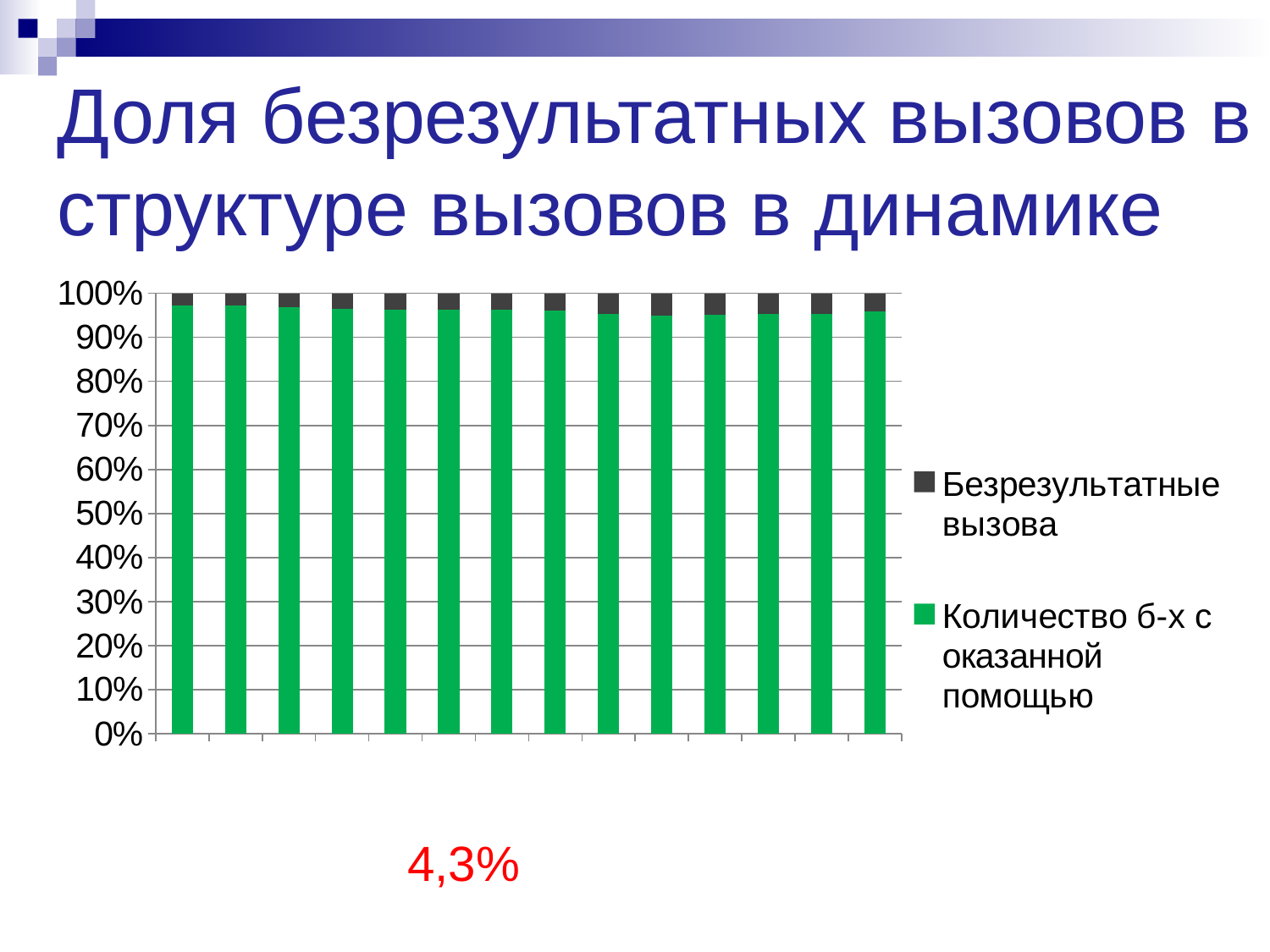
In the leftmost bar, which series has the larger share: Безрезультатные вызова or Количество б-х с оказанной помощью? Количество б-х с оказанной помощью Which series is shown in green in the legend? Количество б-х с оказанной помощью How many series does the legend list? 2 What is the highest tick value shown on the vertical axis? 100% Is the value of the green series (Количество б-х с оказанной помощью) for the leftmost bar greater or less than 90%? greater Is the value of the dark grey series (Безрезультатные вызова) for the leftmost bar greater or less than 10%? less What is the total height of each stacked bar on the percentage axis? 100% What kind of chart is shown on the slide? stacked bar chart What is the title of the chart on the slide? Доля безрезультатных вызовов в структуре вызовов в динамике Is the value of the green series (Количество б-х с оказанной помощью) for the rightmost bar greater or less than 80%? greater How many bars are plotted in the chart? 14